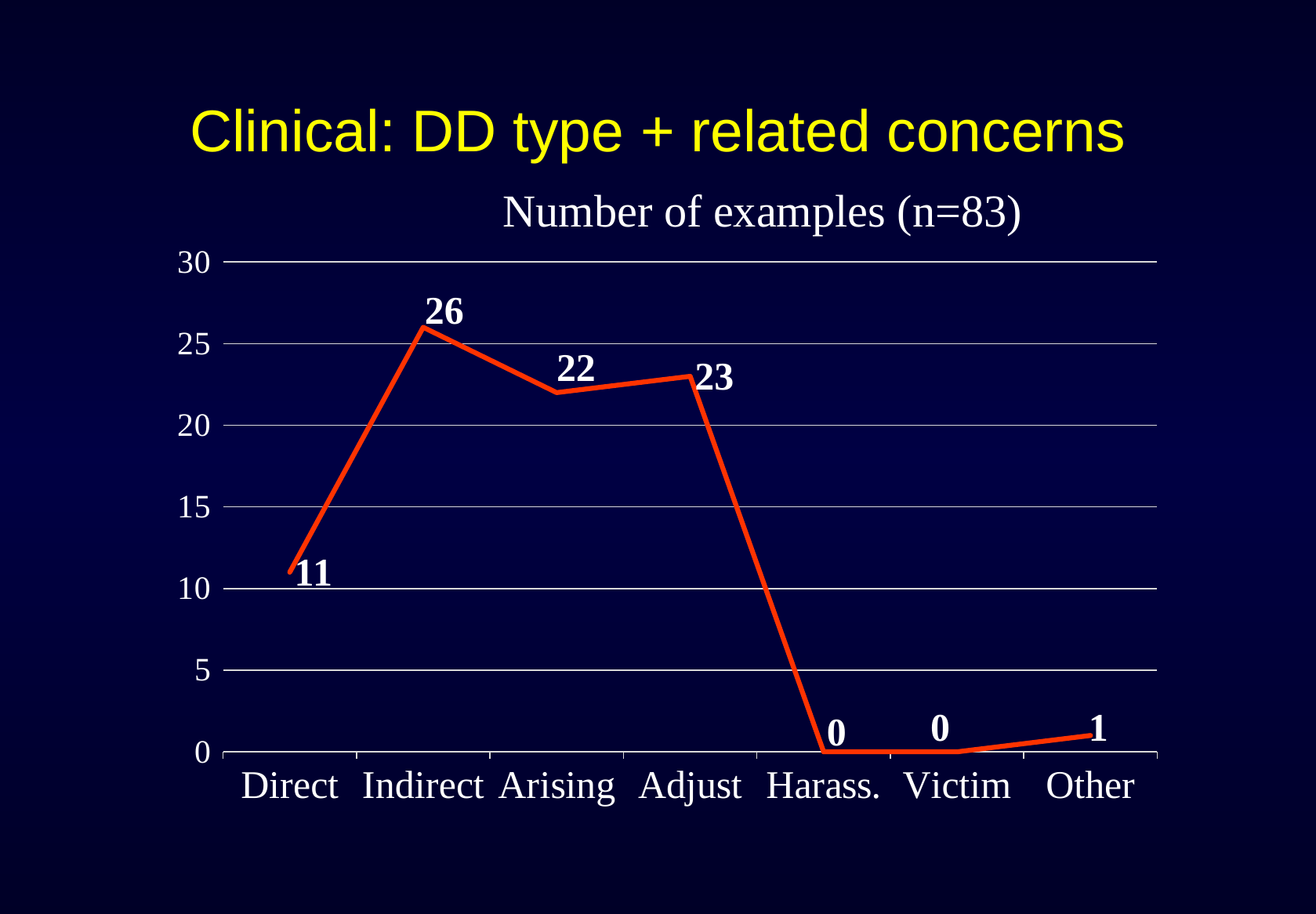
What is the value for Other? 1 What kind of chart is shown on the slide? line chart What is the title of the chart? Number of examples (n=83) Which is larger, the value for Arising or the value for Adjust? Adjust Which category has the highest value? Indirect What is the value for Adjust? 23 What is the value for Indirect? 26 How many categories are shown on the x axis? 7 What is the value for Direct? 11 What is the difference between the values for Adjust and Direct? 12 Is the value for Direct greater or less than 15? less What is the difference between the values for Indirect and Arising? 4